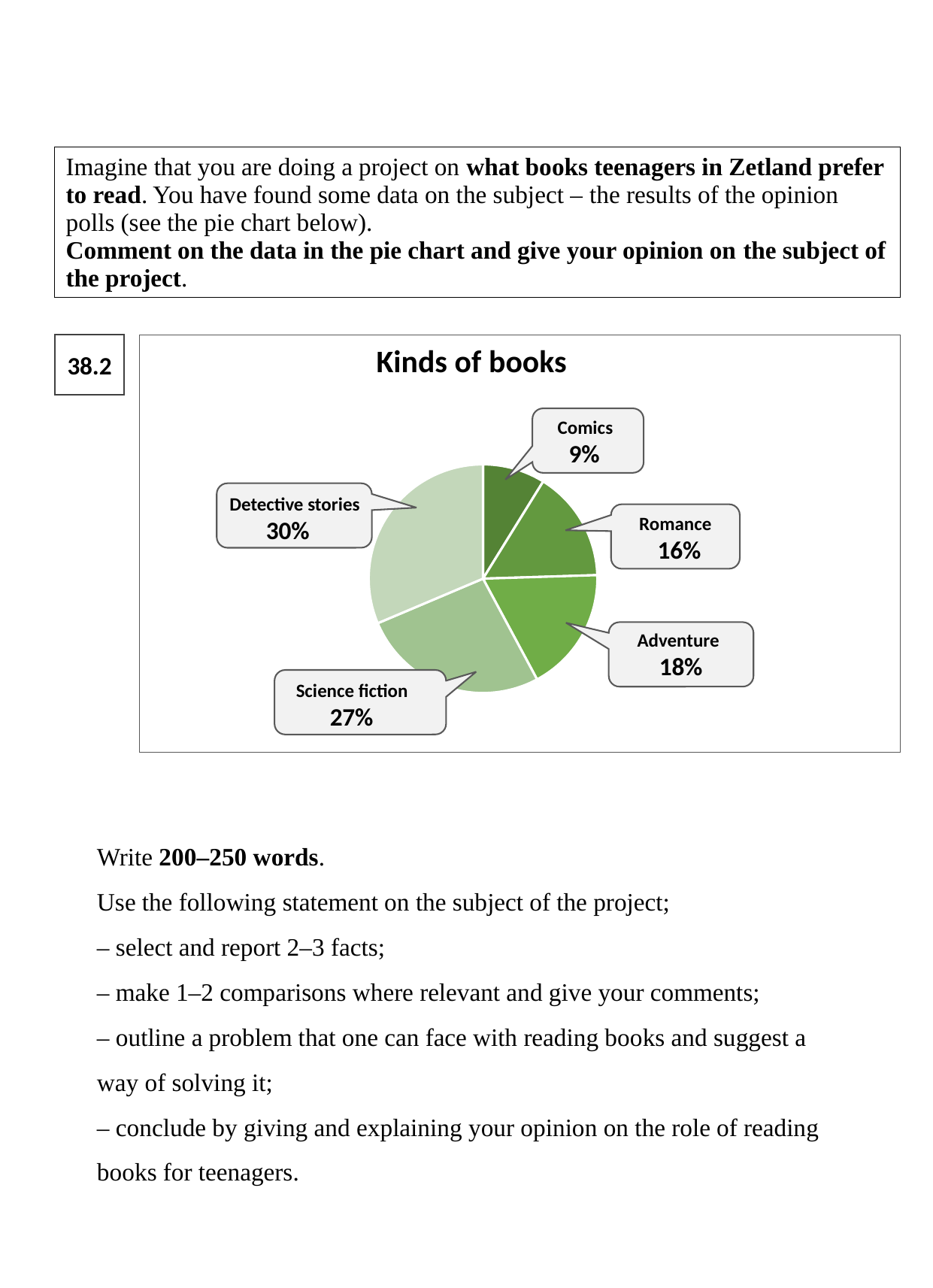
What percentage of the pie chart is Detective stories? 30% What percentage of the pie chart is Comics? 9% What is the title of the pie chart? Kinds of books Which kind of books has the smallest share in the pie chart? Comics What kind of chart is shown on the slide? pie chart What percentage of the pie chart is Science fiction? 27% How many kinds of books are shown in the pie chart? 5 Which kind of books has the largest share in the pie chart? Detective stories What percentage of the pie chart is Romance? 16% What percentage of the pie chart is Adventure? 18% What is the difference in percentage points between Detective stories and Science fiction? 3 Which has a larger share, Adventure or Romance? Adventure